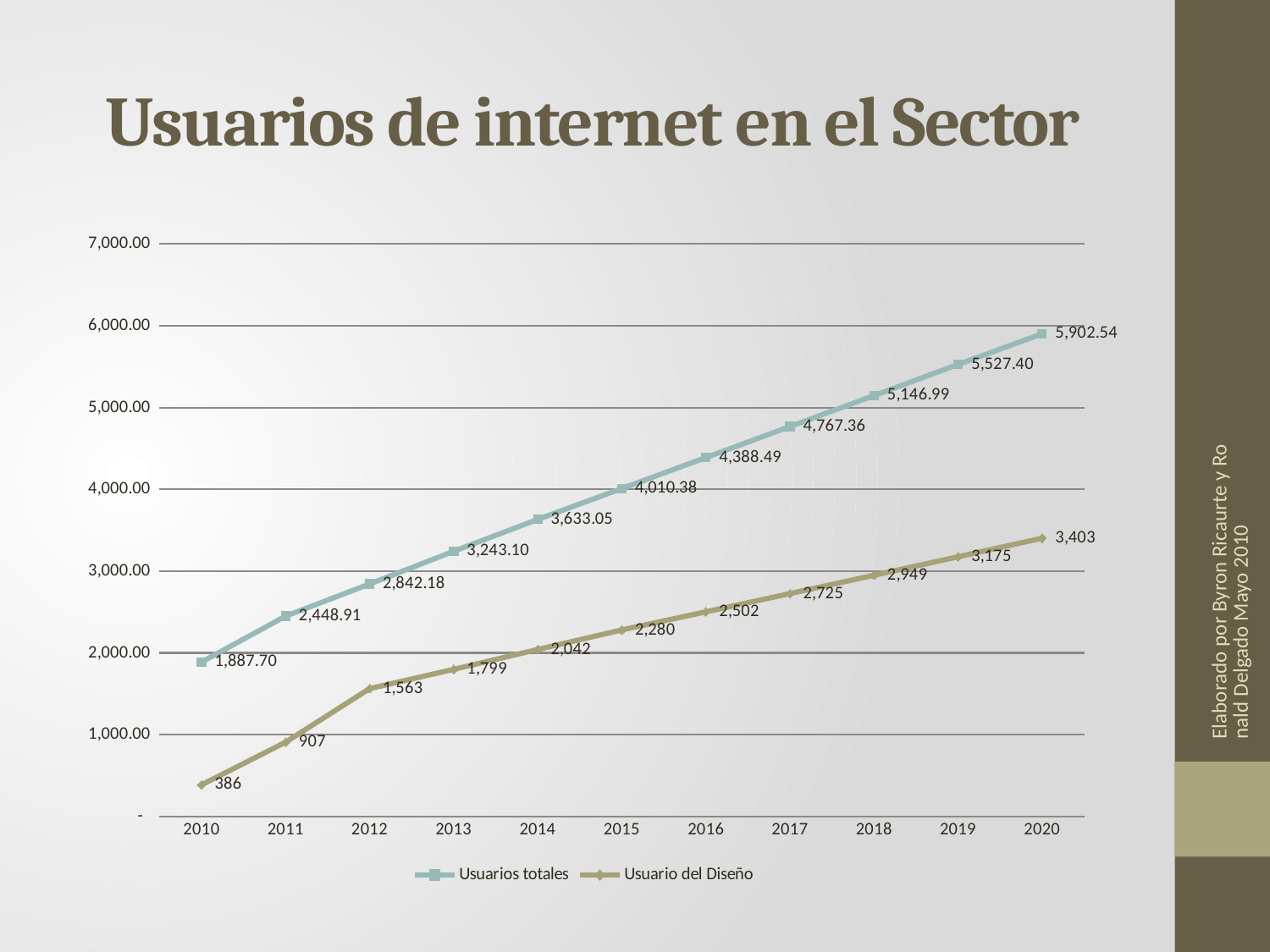
In which year is Usuario del Diseño highest? 2020 How many series does the legend list? 2 How many years are shown on the x axis? 11 What kind of chart is shown on the slide? Line chart What is the value of Usuarios totales in 2015? 4,010.38 What is the value of Usuarios totales in 2020? 5,902.54 What is the value of Usuario del Diseño in 2010? 386 What is the value of Usuario del Diseño in 2016? 2,502 Which is larger in 2013: Usuarios totales or Usuario del Diseño? Usuarios totales What is the difference between Usuarios totales and Usuario del Diseño in 2020? 2,499.54 By how much did Usuario del Diseño increase from 2010 to 2020? 3,017 In which year is Usuarios totales lowest? 2010